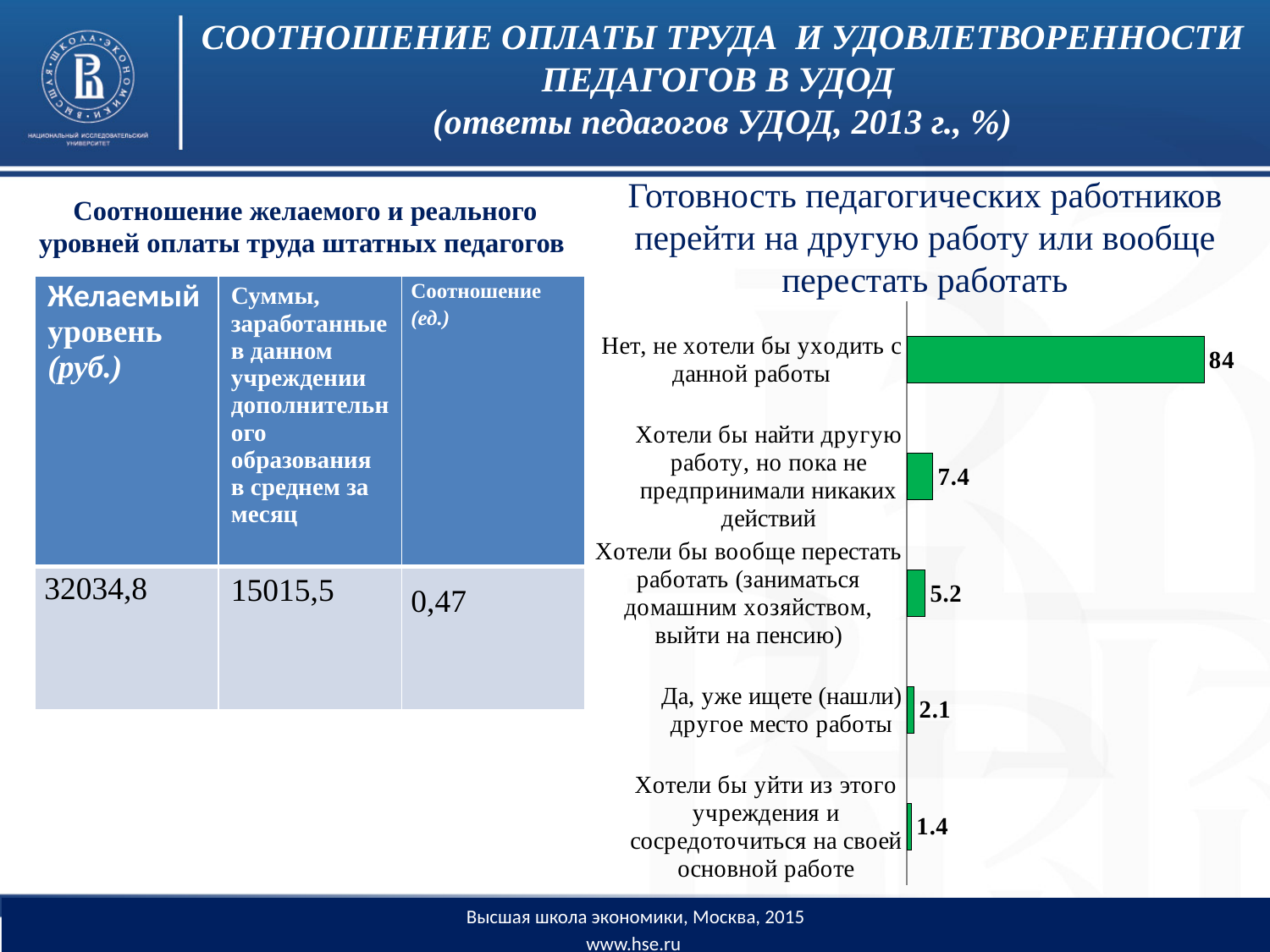
How many categories does the chart show? 5 Which is larger: the value for "Хотели бы вообще перестать работать (заниматься домашним хозяйством, выйти на пенсию)" or for "Да, уже ищете (нашли) другое место работы"? Хотели бы вообще перестать работать (заниматься домашним хозяйством, выйти на пенсию) What is the title of the chart? Готовность педагогических работников перейти на другую работу или вообще перестать работать What is the value for "Нет, не хотели бы уходить с данной работы"? 84 What is the value for "Да, уже ищете (нашли) другое место работы"? 2.1 What is the value for "Хотели бы найти другую работу, но пока не предпринимали никаких действий"? 7.4 What is the difference between the values for "Хотели бы найти другую работу, но пока не предпринимали никаких действий" and "Хотели бы вообще перестать работать (заниматься домашним хозяйством, выйти на пенсию)"? 2.2 What is the value for "Хотели бы уйти из этого учреждения и сосредоточиться на своей основной работе"? 1.4 Which category has the highest value? Нет, не хотели бы уходить с данной работы What kind of chart is shown on the slide? Bar chart What colour are the bars in the chart? Green Which category has the lowest value? Хотели бы уйти из этого учреждения и сосредоточиться на своей основной работе